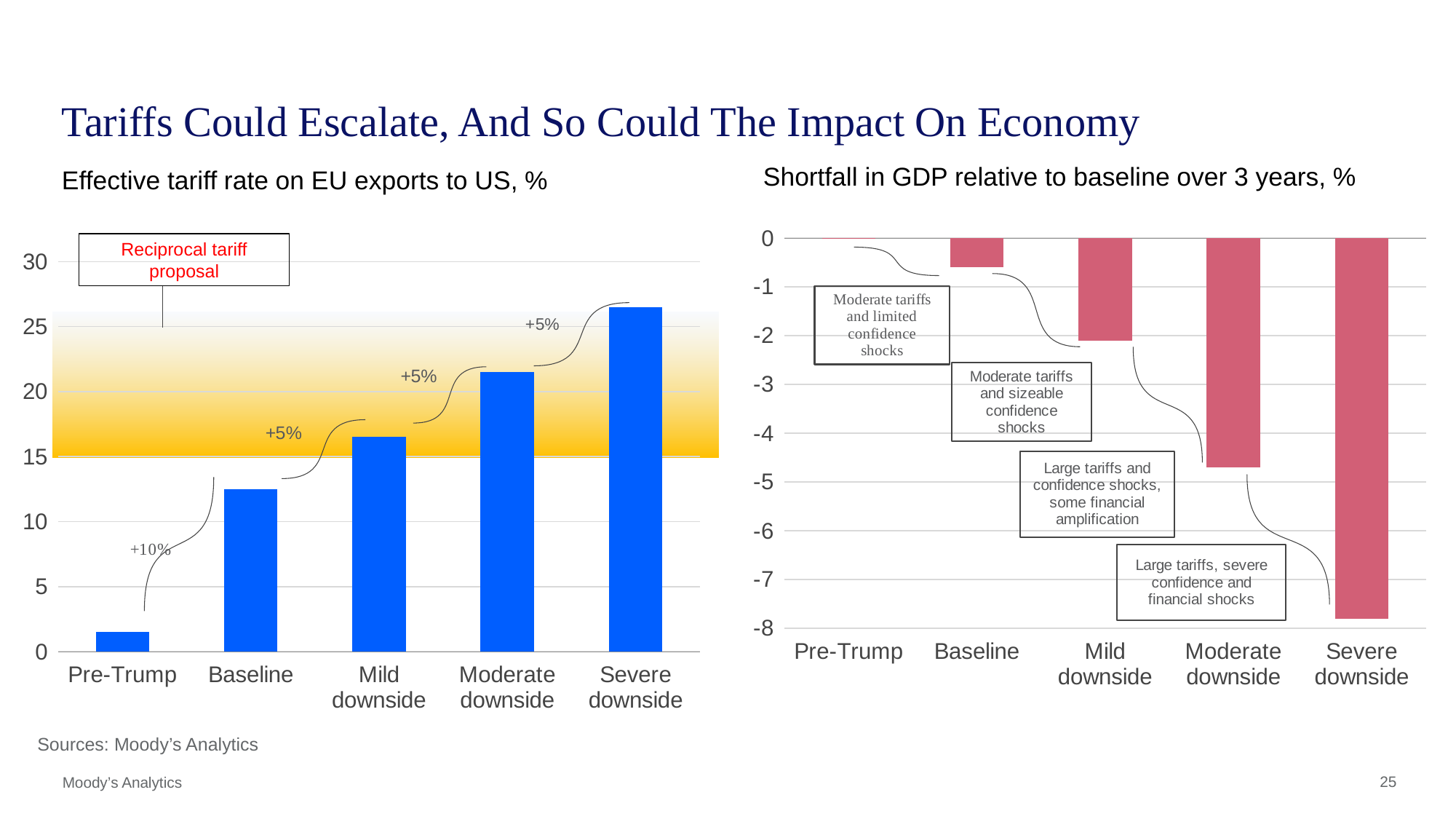
On the 'Effective tariff rate on EU exports to US, %' chart, what increase is annotated between Pre-Trump and Baseline? +10% On the 'Shortfall in GDP relative to baseline over 3 years, %' chart, which has the larger shortfall, Mild downside or Moderate downside? Moderate downside On the 'Shortfall in GDP relative to baseline over 3 years, %' chart, which scenario shows the largest GDP shortfall? Severe downside On the 'Shortfall in GDP relative to baseline over 3 years, %' chart, is the value for Moderate downside greater or less than -4? less What kind of chart is the 'Effective tariff rate on EU exports to US, %' chart on the left? bar chart On the 'Effective tariff rate on EU exports to US, %' chart, is the value for Severe downside greater or less than 25? greater How many scenario categories are shown on the 'Effective tariff rate on EU exports to US, %' chart? 5 On the 'Effective tariff rate on EU exports to US, %' chart, is the value for Baseline greater or less than 15? less On the 'Effective tariff rate on EU exports to US, %' chart, which scenario has the highest tariff rate? Severe downside On the 'Effective tariff rate on EU exports to US, %' chart, which scenario has the lowest tariff rate? Pre-Trump On the 'Effective tariff rate on EU exports to US, %' chart, do the values rise or fall moving from Pre-Trump to Severe downside? rise What kind of chart is the 'Shortfall in GDP relative to baseline over 3 years, %' chart on the right? bar chart